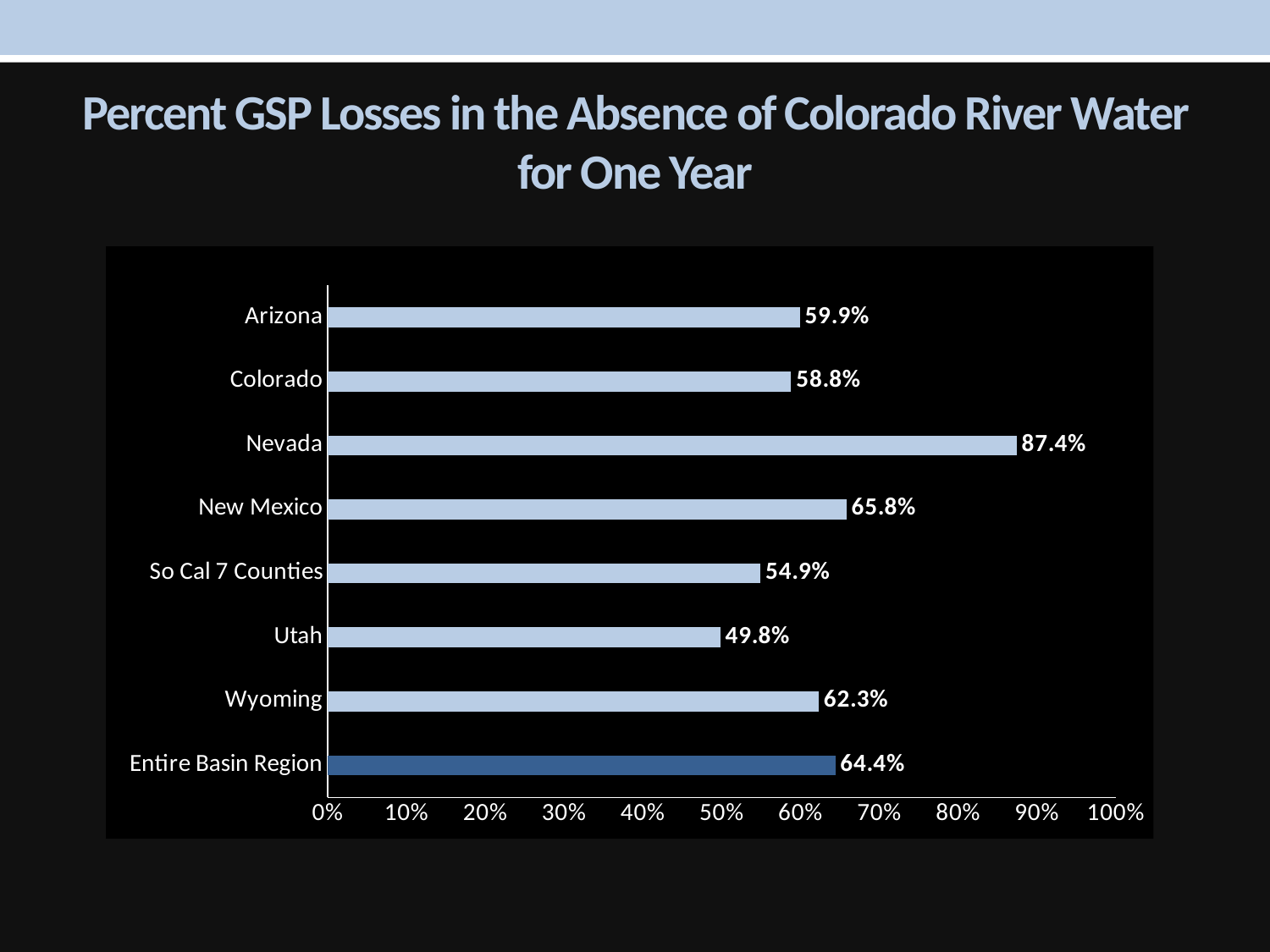
What kind of chart is shown on the slide? Bar chart What is the difference between the percent GSP loss for New Mexico and for Colorado? 7.0% How many categories are shown in the chart? 8 Which has a larger percent GSP loss, Wyoming or So Cal 7 Counties? Wyoming What is the difference between the percent GSP loss for Nevada and for Utah? 37.6% What is the title of the chart on the slide? Percent GSP Losses in the Absence of Colorado River Water for One Year What is the percent GSP loss for the Entire Basin Region? 64.4% Which category has the lowest percent GSP loss? Utah What is the percent GSP loss for Nevada? 87.4% Which category has the highest percent GSP loss? Nevada What is the percent GSP loss for Utah? 49.8% Is the value for Arizona greater or less than 50%? greater